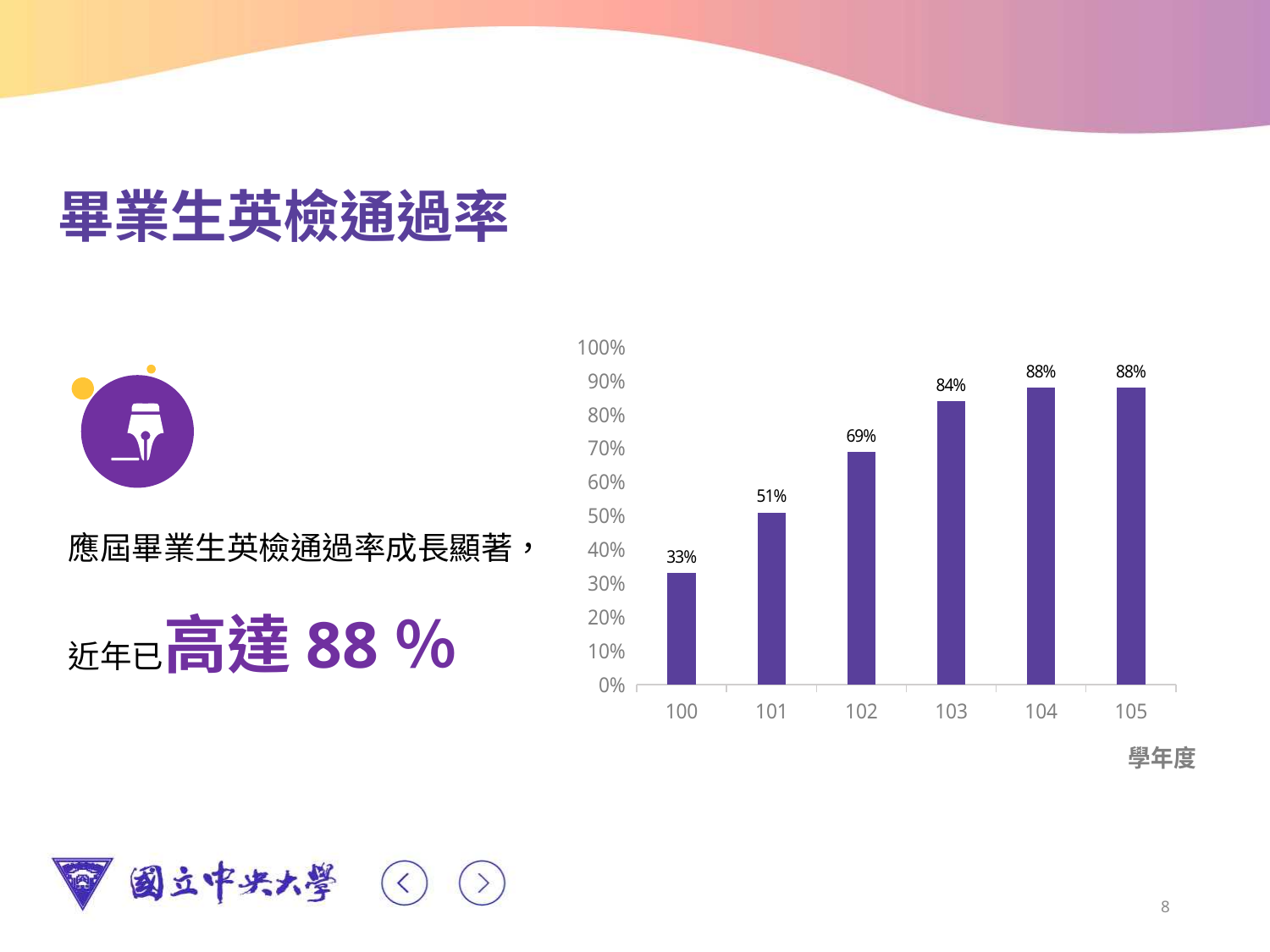
How many academic years are shown on the x axis? 6 What is the pass rate shown for academic year 103? 84% What is the pass rate shown for academic year 102? 69% What is the English proficiency test pass rate for academic year 100? 33% What is the x-axis label of the chart? 學年度 Which academic year has the lowest pass rate? 100 What is the difference in pass rate between academic year 103 and academic year 102? 15% What is the difference in pass rate between academic year 101 and academic year 100? 18% Which has a higher pass rate, academic year 101 or academic year 102? 102 Do the pass rates generally rise or fall from academic year 100 to 105? rise Is the pass rate for academic year 102 greater or less than 60%? greater What kind of chart is shown on the slide? bar chart